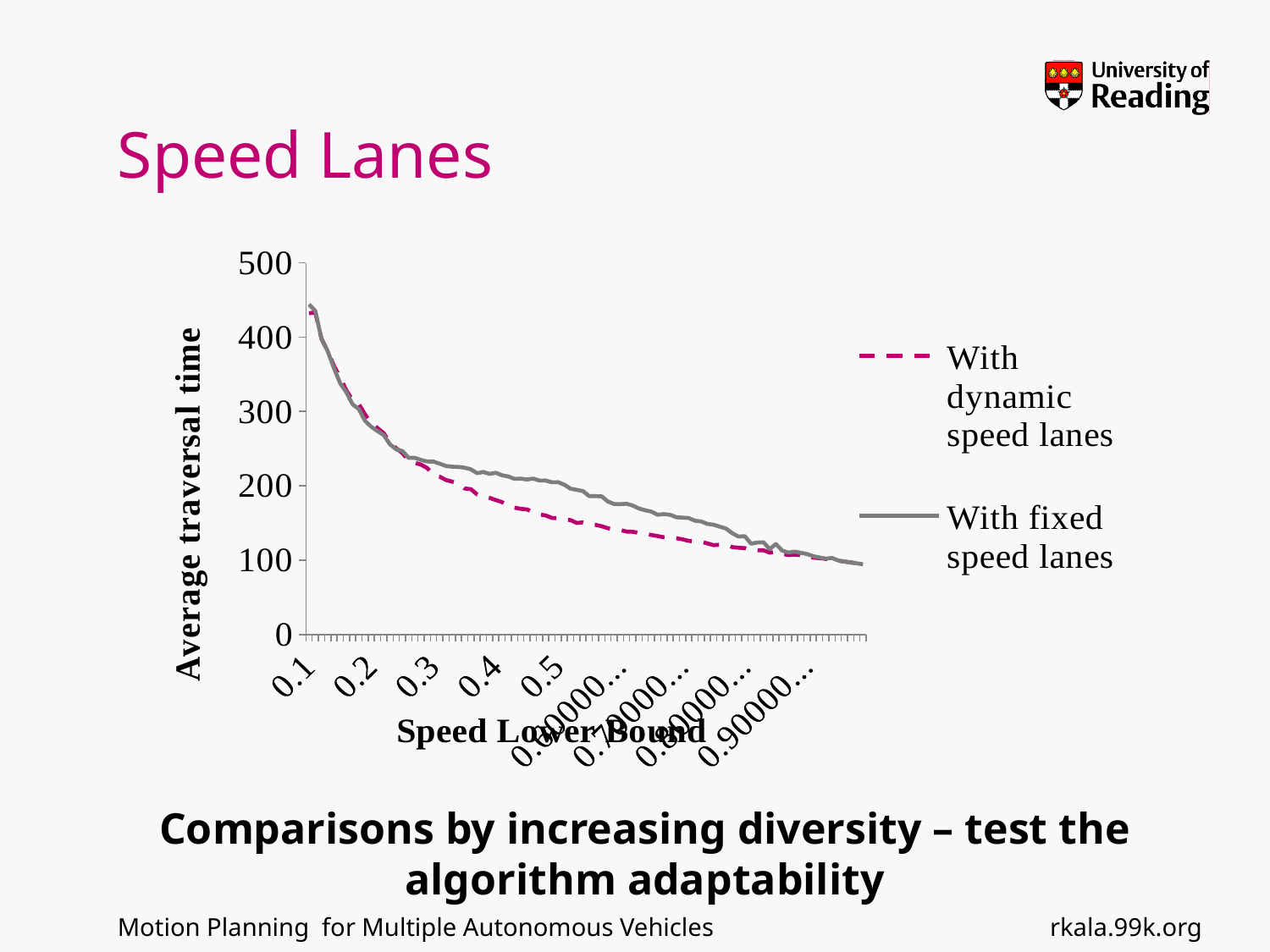
Which series is drawn with a dashed line? With dynamic speed lanes Is the value for 'With fixed speed lanes' at a speed lower bound of 0.1 greater or less than 400? greater Is the value for 'With dynamic speed lanes' at a speed lower bound of 0.4 greater or less than 200? less Do the values for 'With dynamic speed lanes' rise or fall along the x axis? fall Is the value for 'With dynamic speed lanes' at a speed lower bound of 0.3 greater or less than 300? less Do the values for 'With fixed speed lanes' rise or fall as the speed lower bound increases? fall What kind of chart is shown on the slide? line chart What is the label of the vertical axis of the chart? Average traversal time At a speed lower bound of 0.5, which series has the higher average traversal time, 'With fixed speed lanes' or 'With dynamic speed lanes'? With fixed speed lanes How many series does the legend list? 2 At a speed lower bound of 0.4, which series has the lower average traversal time? With dynamic speed lanes